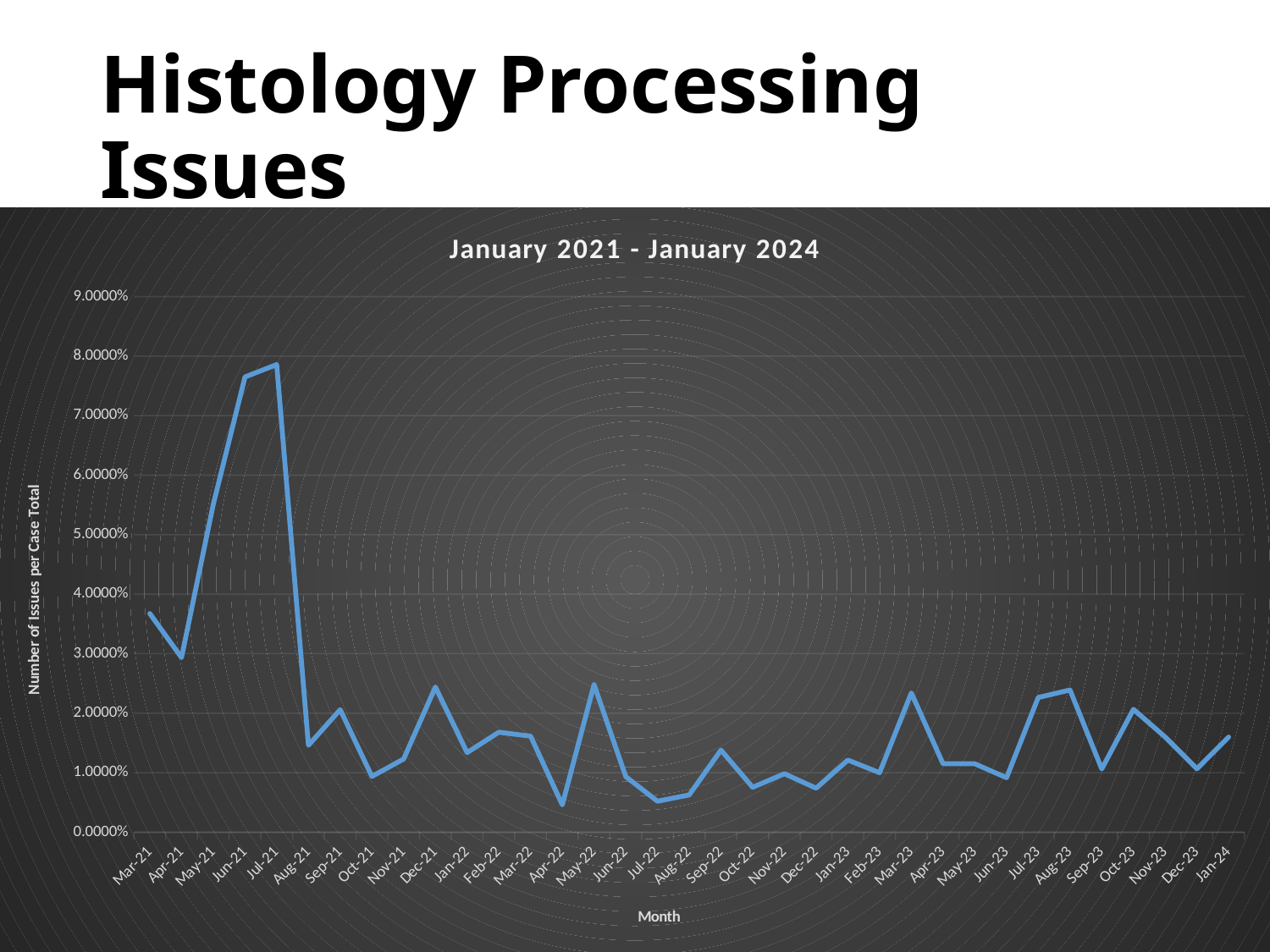
How many months are plotted along the x axis of the chart? 35 Which is larger, the value for Mar-21 or the value for Apr-21? Mar-21 Does the value rise or fall from Jul-21 to Aug-21? fall Is the value for Mar-23 greater or less than 2.0000%? greater What is the title of the chart? January 2021 - January 2024 Is the value for Mar-21 greater or less than 3.0000%? greater What is the label on the vertical axis of the chart? Number of Issues per Case Total What kind of chart is shown on the slide? line chart Is the value for Apr-22 greater or less than 1.0000%? less Which month has the highest value on the chart? Jul-21